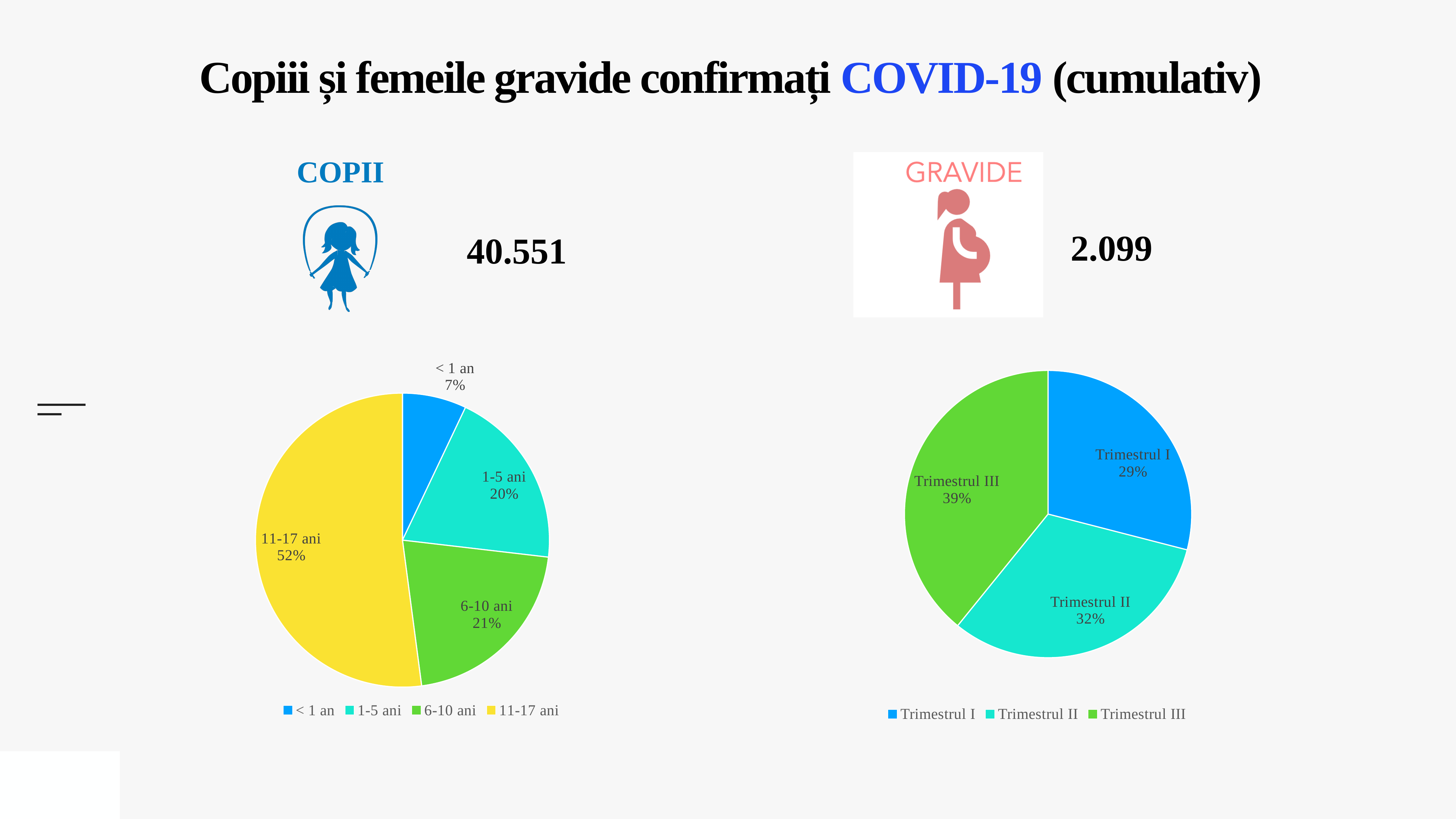
In the GRAVIDE pie chart on the right, how many entries does the legend list? 3 In the GRAVIDE pie chart on the right, what is the difference in percentage points between Trimestrul III and Trimestrul I? 10 In the COPII pie chart on the left, what share does the < 1 an slice have? 7% In the COPII pie chart on the left, which age group has the largest share? 11-17 ani In the COPII pie chart on the left, what share does the 11-17 ani slice have? 52% In the COPII pie chart on the left, which age group has the smallest share? < 1 an In the COPII pie chart on the left, how many age groups are shown? 4 In the GRAVIDE pie chart on the right, which trimester has the largest share? Trimestrul III What type of chart is used for the COPII data on the left? Pie chart In the COPII pie chart on the left, what is the difference in percentage points between the 11-17 ani slice and the 1-5 ani slice? 32 In the GRAVIDE pie chart on the right, what share does Trimestrul II have? 32% In the GRAVIDE pie chart on the right, which trimester has the smallest share? Trimestrul I